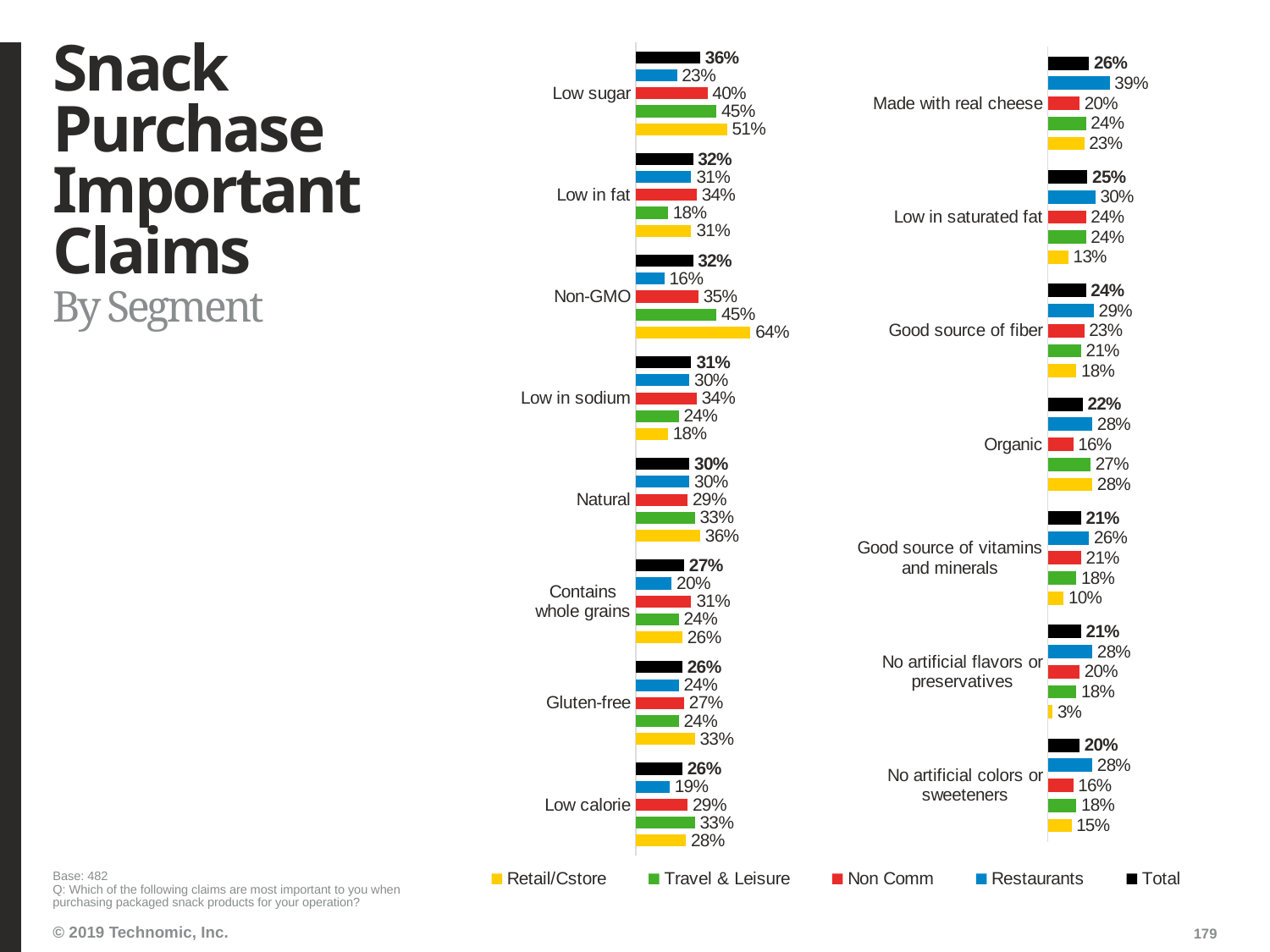
On the left chart, which claim has the highest Retail/Cstore value? Non-GMO On the right chart, which claim has the lowest Retail/Cstore value? No artificial flavors or preservatives On the left chart, what is the Total value for Low sugar? 36% On the right chart, what is the Retail/Cstore value for No artificial flavors or preservatives? 3% On the right chart, what is the Restaurants value for Made with real cheese? 39% How many claims are shown on the right chart? 7 What type of chart is used on this slide? Bar chart How many series does the legend list? 5 On the left chart, what is the difference between the Retail/Cstore and Restaurants values for Low sugar? 28 percentage points On the right chart, which is larger for Organic: the Non Comm value or the Travel & Leisure value? Travel & Leisure On the left chart, what is the Retail/Cstore value for Non-GMO? 64% How many claims are shown on the left chart? 8